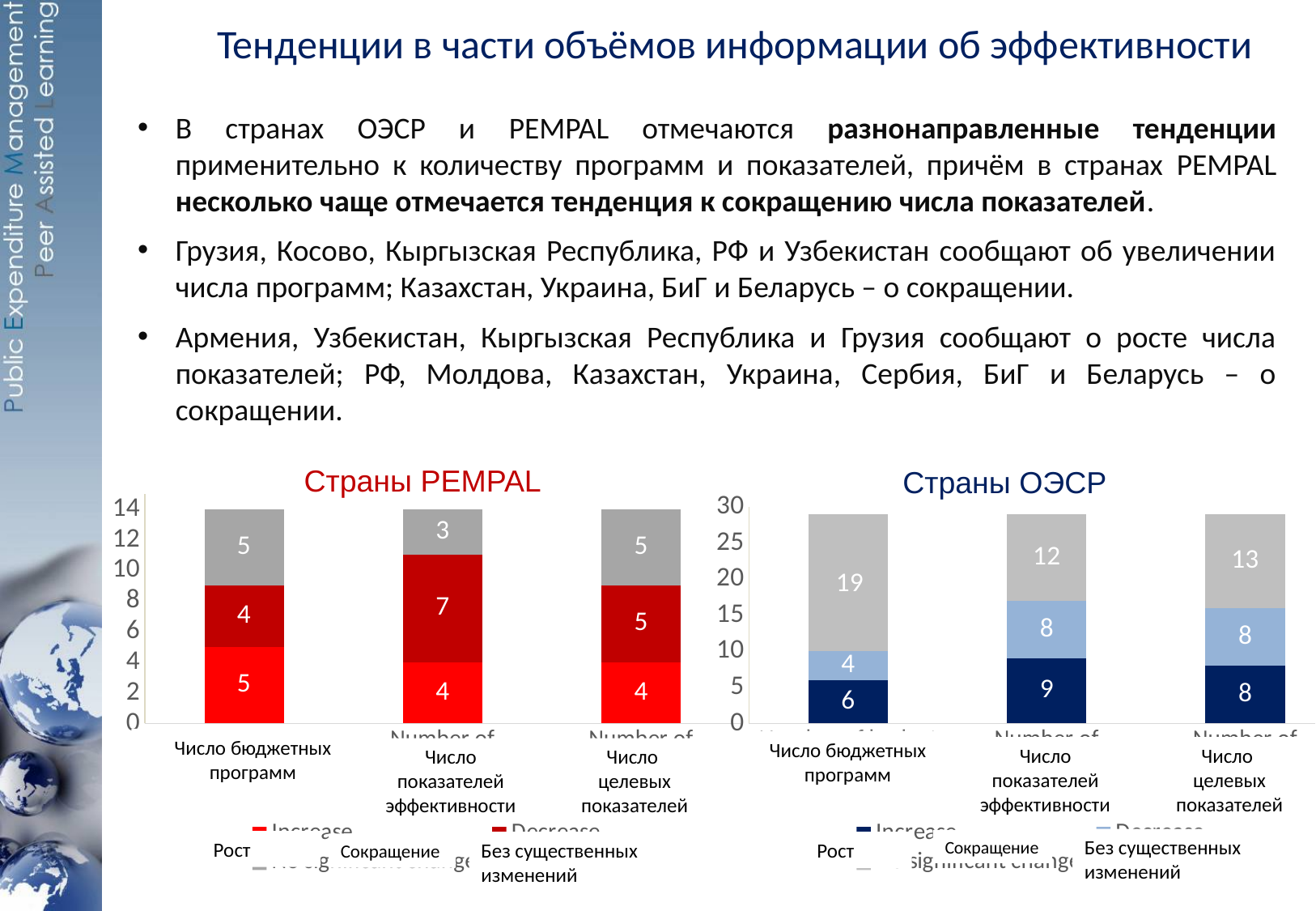
In the 'Страны PEMPAL' chart, which is larger: 'Рост' for 'Число бюджетных программ' or 'Рост' for 'Число целевых показателей'? Число бюджетных программ In the 'Страны ОЭСР' chart, what is the value of 'Без существенных изменений' for 'Число бюджетных программ'? 19 In the 'Страны ОЭСР' chart, what is the total of the stacked bar for 'Число целевых показателей'? 29 How many categories are shown on the x axis of the 'Страны ОЭСР' chart? 3 What type of chart is the 'Страны PEMPAL' chart? Stacked bar chart In the 'Страны PEMPAL' chart, which category has the highest 'Сокращение' value? Число показателей эффективности In the 'Страны ОЭСР' chart, which category has the lowest 'Без существенных изменений' value? Число показателей эффективности In the 'Страны PEMPAL' chart, what is the total of the stacked bar for 'Число показателей эффективности'? 14 In the 'Страны PEMPAL' chart, what is the value of 'Рост' for 'Число бюджетных программ'? 5 In the 'Страны ОЭСР' chart, what is the value of 'Рост' for 'Число показателей эффективности'? 9 In the 'Страны PEMPAL' chart, what is the value of 'Сокращение' for 'Число показателей эффективности'? 7 In the 'Страны ОЭСР' chart, what is the difference between 'Без существенных изменений' for 'Число бюджетных программ' and for 'Число целевых показателей'? 6